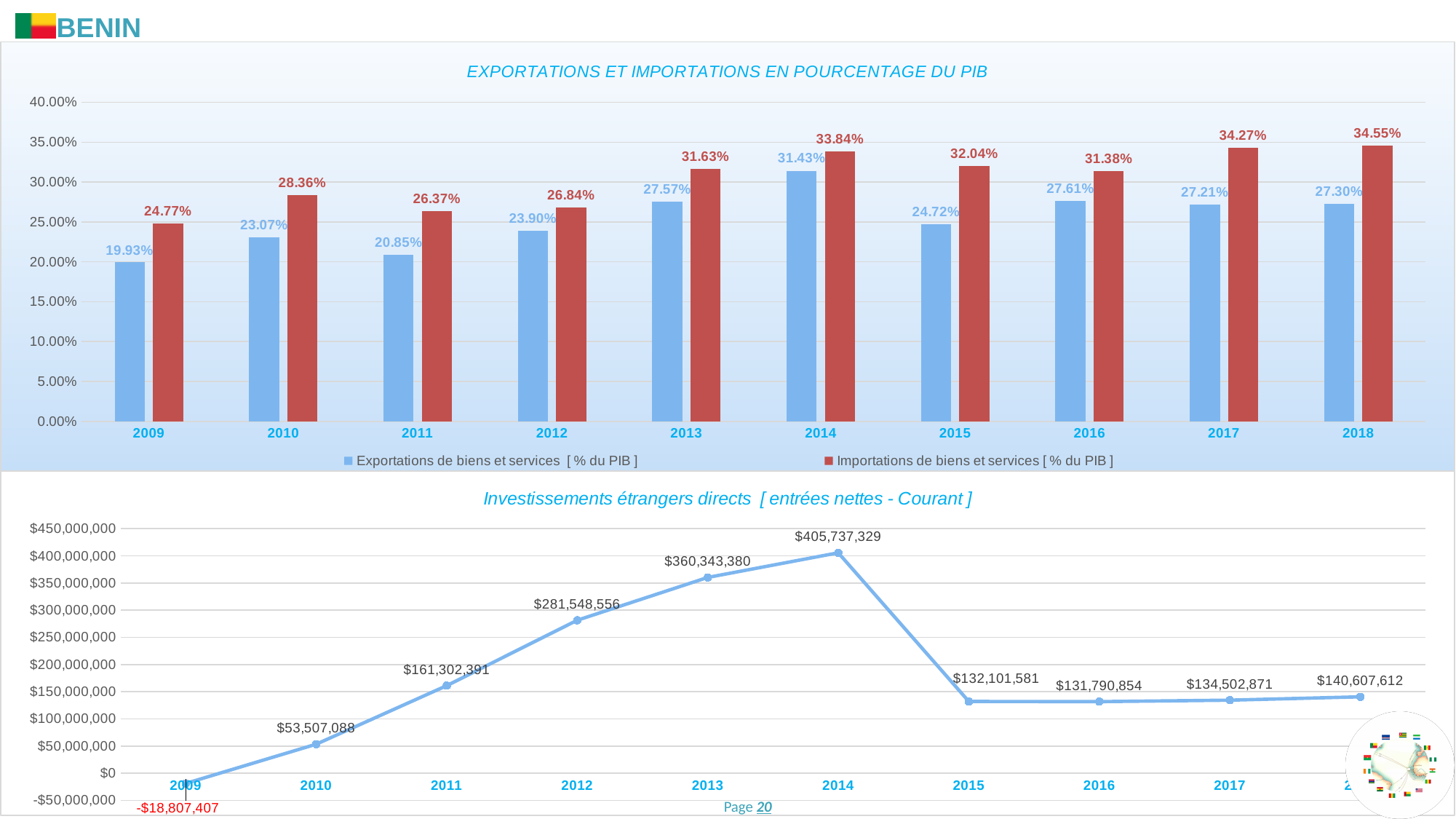
In the chart titled 'EXPORTATIONS ET IMPORTATIONS EN POURCENTAGE DU PIB', what is the value of Importations de biens et services for 2011? 26.37% In the chart titled 'Investissements étrangers directs', is the value for 2016 larger or smaller than the value for 2017? Smaller In the chart titled 'EXPORTATIONS ET IMPORTATIONS EN POURCENTAGE DU PIB', how many series does the legend list? 2 In the chart titled 'EXPORTATIONS ET IMPORTATIONS EN POURCENTAGE DU PIB', what is the difference between Importations and Exportations in 2018? 7.25% In the chart titled 'Investissements étrangers directs', what is the value for 2013? $360,343,380 In the chart titled 'Investissements étrangers directs', which year has the highest value? 2014 In the chart titled 'EXPORTATIONS ET IMPORTATIONS EN POURCENTAGE DU PIB', what is the value of Exportations de biens et services for 2014? 31.43% What kind of chart is the top chart titled 'EXPORTATIONS ET IMPORTATIONS EN POURCENTAGE DU PIB'? Bar chart In the chart titled 'EXPORTATIONS ET IMPORTATIONS EN POURCENTAGE DU PIB', which year has the lowest value for Exportations de biens et services? 2009 In the chart titled 'Investissements étrangers directs', which year has the lowest value? 2009 In the chart titled 'EXPORTATIONS ET IMPORTATIONS EN POURCENTAGE DU PIB', which year has the highest value for Importations de biens et services? 2018 In the chart titled 'Investissements étrangers directs', how many years are plotted on the x axis? 10